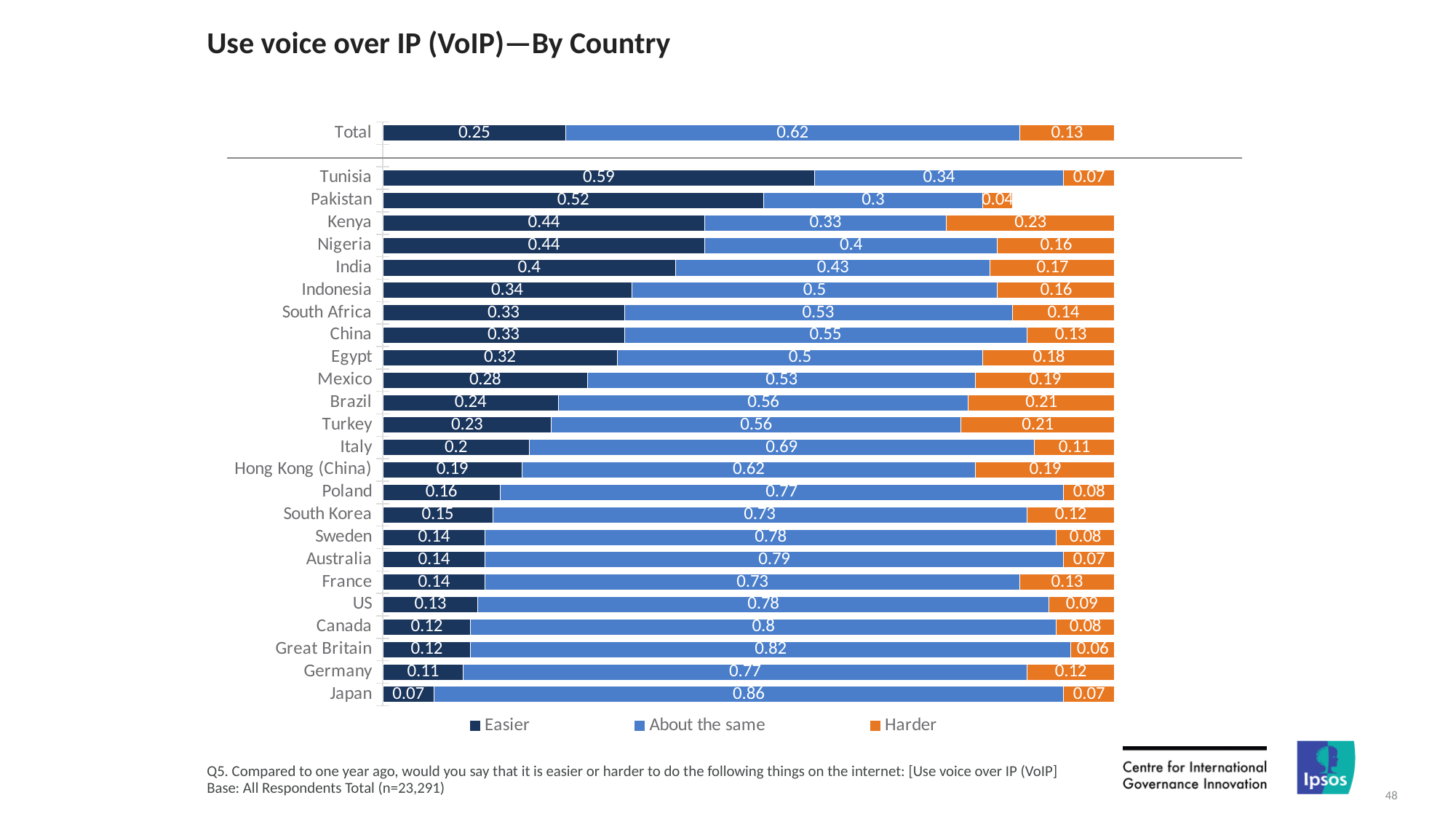
What is the 'Easier' value for Tunisia? 0.59 What is the 'Harder' value for Kenya? 0.23 Which has a larger 'Harder' value, Kenya or Italy? Kenya What is the difference between the 'Easier' values for Tunisia and Japan? 0.52 Which country has the lowest 'Easier' value? Japan Which country has the highest 'Easier' value? Tunisia What kind of chart is shown on the slide? Stacked bar chart What is the 'About the same' value for Japan? 0.86 Which country has the lowest 'Harder' value? Pakistan What is the total of the three segments in the Total bar? 1 How many countries (excluding Total) are shown in the chart? 24 How many series does the legend list? 3